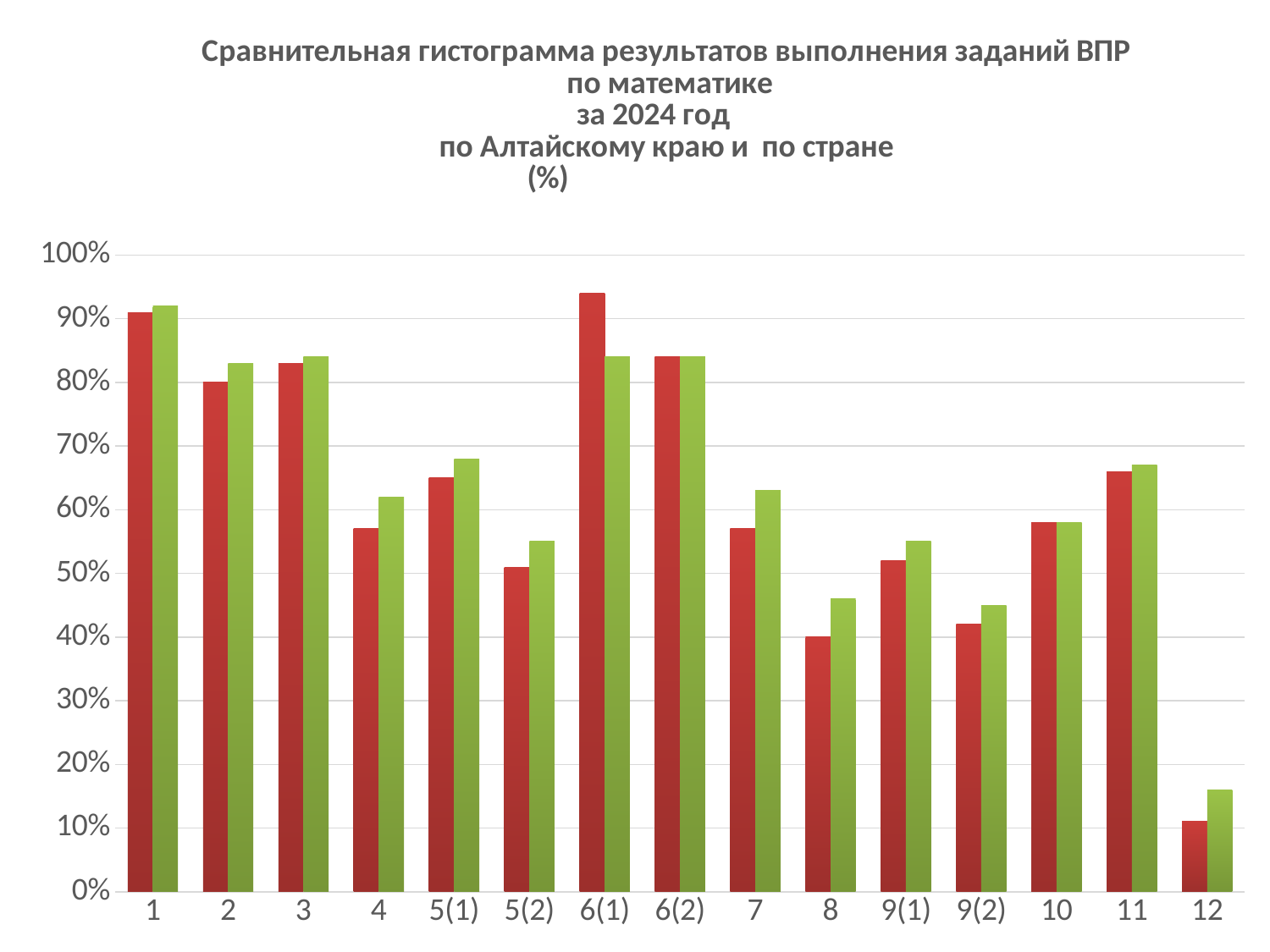
What kind of chart is shown on the slide? bar chart For category 6(1), which bar is taller, the red one or the green one? the red one Which category has the shortest green bar? 12 Is the green bar for category 8 greater or less than 50%? less Which category has the tallest red bar? 6(1) For category 7, which bar is taller, the red one or the green one? the green one How many categories are shown along the x axis? 15 Which category has the tallest green bar? 1 Which category has the shortest red bar? 12 Is the red bar for category 12 greater or less than 20%? less What year do the results in the chart title refer to? 2024 Is the red bar for category 6(1) greater or less than 90%? greater